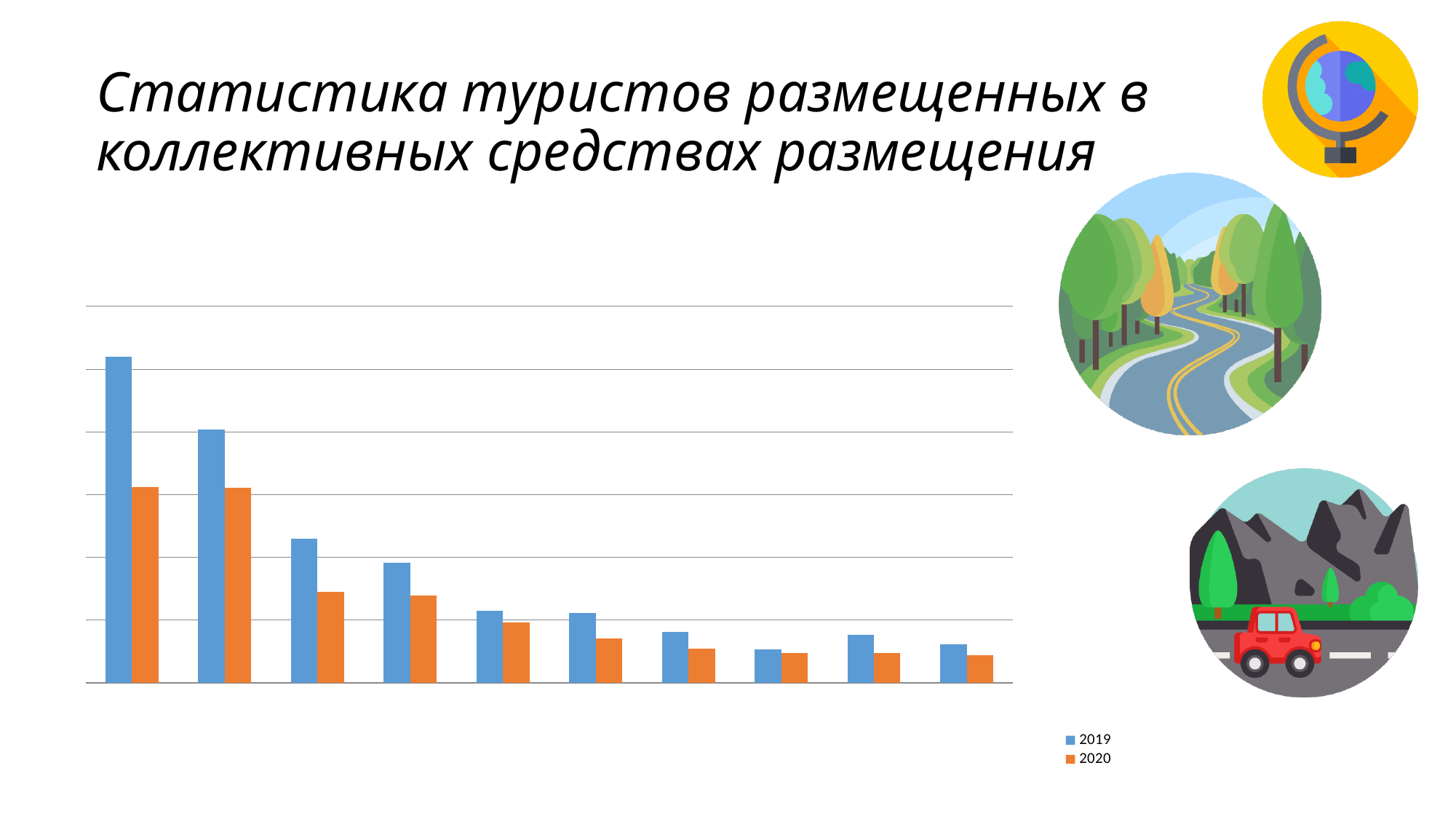
How many groups of bars (categories) are plotted in the chart? 10 Which series, 2019 or 2020, has the taller bar in every group of the chart? 2019 What are the entries in the chart's legend? 2019 and 2020 Which group of bars has the tallest 2019 bar in the chart? The leftmost group What kind of chart is shown on the slide? Bar chart How many series does the legend of the chart list? 2 For the 2019 series, is the leftmost bar taller or shorter than the second bar from the left? Taller What colour are the bars for the 2020 series? Orange In the leftmost group of bars, which series has the taller bar, 2019 or 2020? 2019